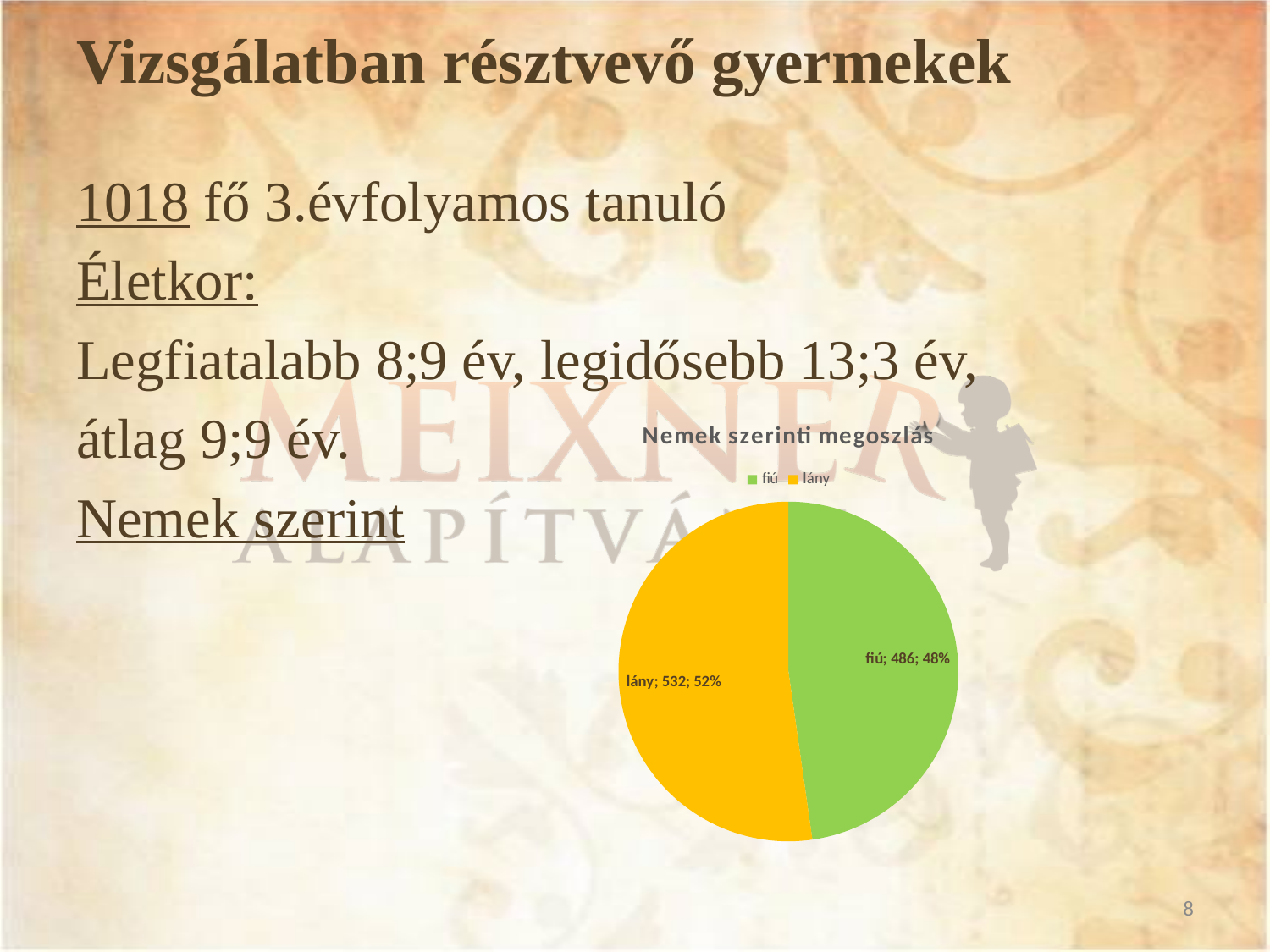
What is the difference between the lány and fiú values? 46 What is the total of the two slices in the pie chart? 1018 What share of the pie does the fiú slice represent? 48% How many slices does the pie chart have? 2 What is the value for lány in the pie chart? 532 What is the value for fiú in the pie chart? 486 What share of the pie does the lány slice represent? 52% Which colour represents lány in the pie chart? orange/yellow Which category has the smallest slice in the pie chart? fiú What kind of chart is shown on the slide? pie chart What is the title of the chart? Nemek szerinti megoszlás Which category has the larger slice, fiú or lány? lány